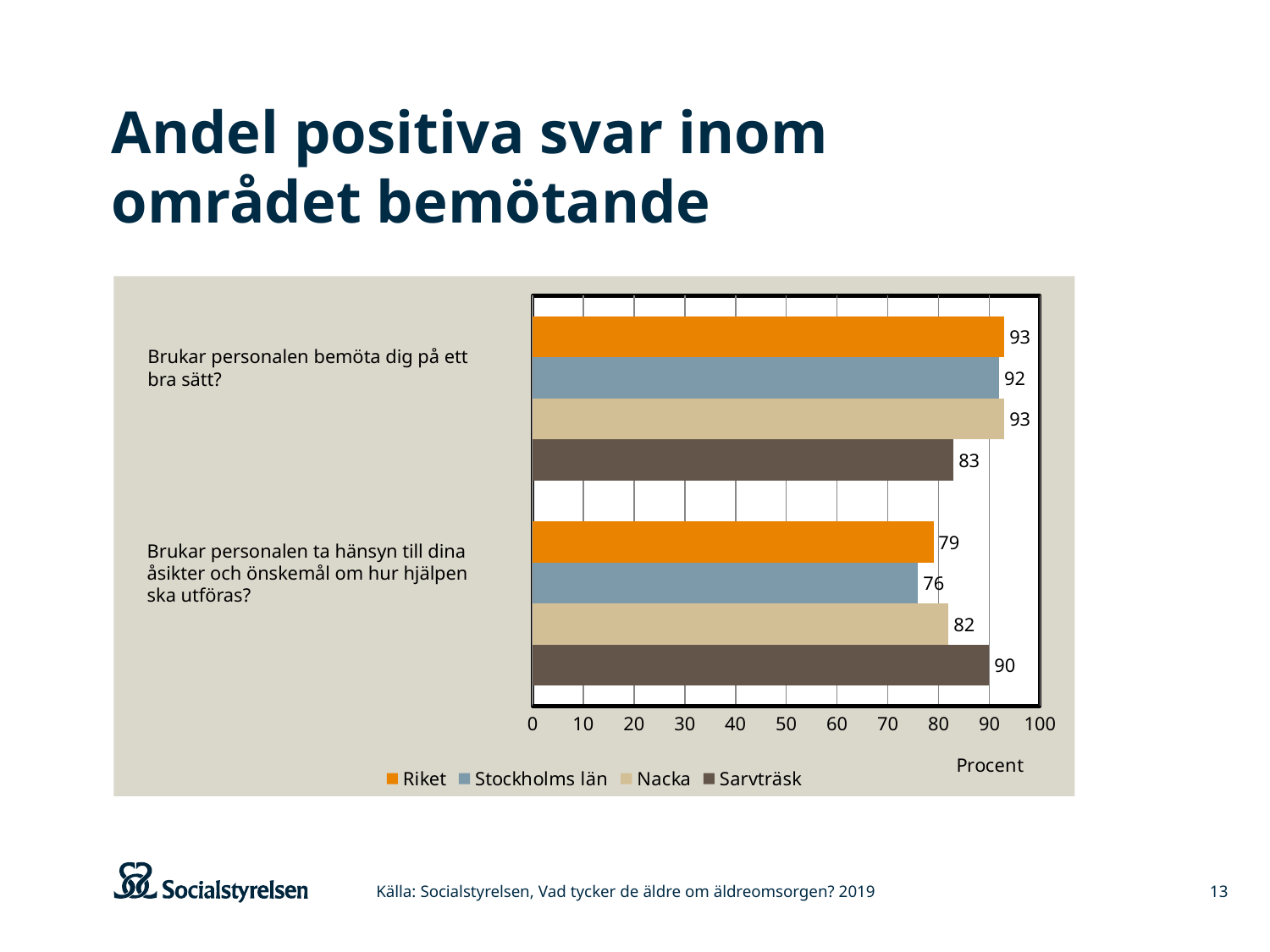
Which series has the highest value for the question "Brukar personalen ta hänsyn till dina åsikter och önskemål om hur hjälpen ska utföras?"? Sarvträsk What is the value for Riket for the question "Brukar personalen ta hänsyn till dina åsikter och önskemål om hur hjälpen ska utföras?"? 79 How many series does the legend list? 4 What is the value for Sarvträsk for the question "Brukar personalen bemöta dig på ett bra sätt?"? 83 What is the difference between the Sarvträsk and Stockholms län values for the question "Brukar personalen ta hänsyn till dina åsikter och önskemål om hur hjälpen ska utföras?"? 14 For the question "Brukar personalen ta hänsyn till dina åsikter och önskemål om hur hjälpen ska utföras?", which is larger: the value for Nacka or the value for Riket? Nacka How many questions (categories) are shown on the chart? 2 What unit is shown on the horizontal axis of the chart? Procent What kind of chart is shown on the slide? Bar chart What is the value for Stockholms län for the question "Brukar personalen ta hänsyn till dina åsikter och önskemål om hur hjälpen ska utföras?"? 76 What is the difference between the Nacka and Sarvträsk values for the question "Brukar personalen bemöta dig på ett bra sätt?"? 10 Which series has the lowest value for the question "Brukar personalen bemöta dig på ett bra sätt?"? Sarvträsk